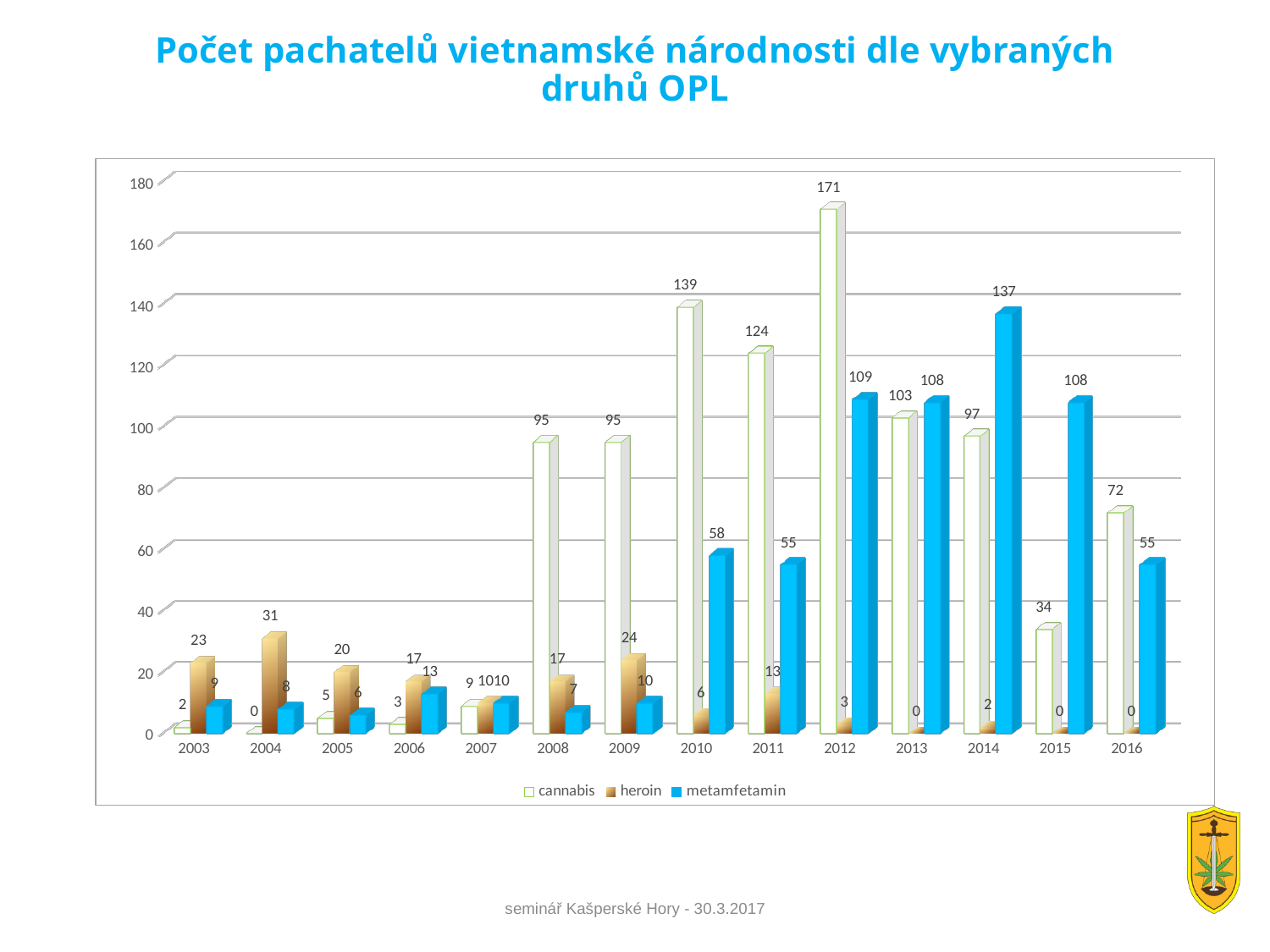
What is the title of the chart? Počet pachatelů vietnamské národnosti dle vybraných druhů OPL How many series does the legend list? 3 What is the cannabis value for 2012? 171 What is the heroin value for 2004? 31 In which year is the cannabis value highest? 2012 What is the difference between the cannabis value and the metamfetamin value in 2012? 62 What kind of chart is shown on the slide? bar chart What is the metamfetamin value for 2014? 137 Which is larger in 2014, the cannabis value or the metamfetamin value? metamfetamin How many years are shown on the x axis? 14 In which year is the heroin value highest? 2004 Does the heroin value rise or fall from 2009 to 2016? fall